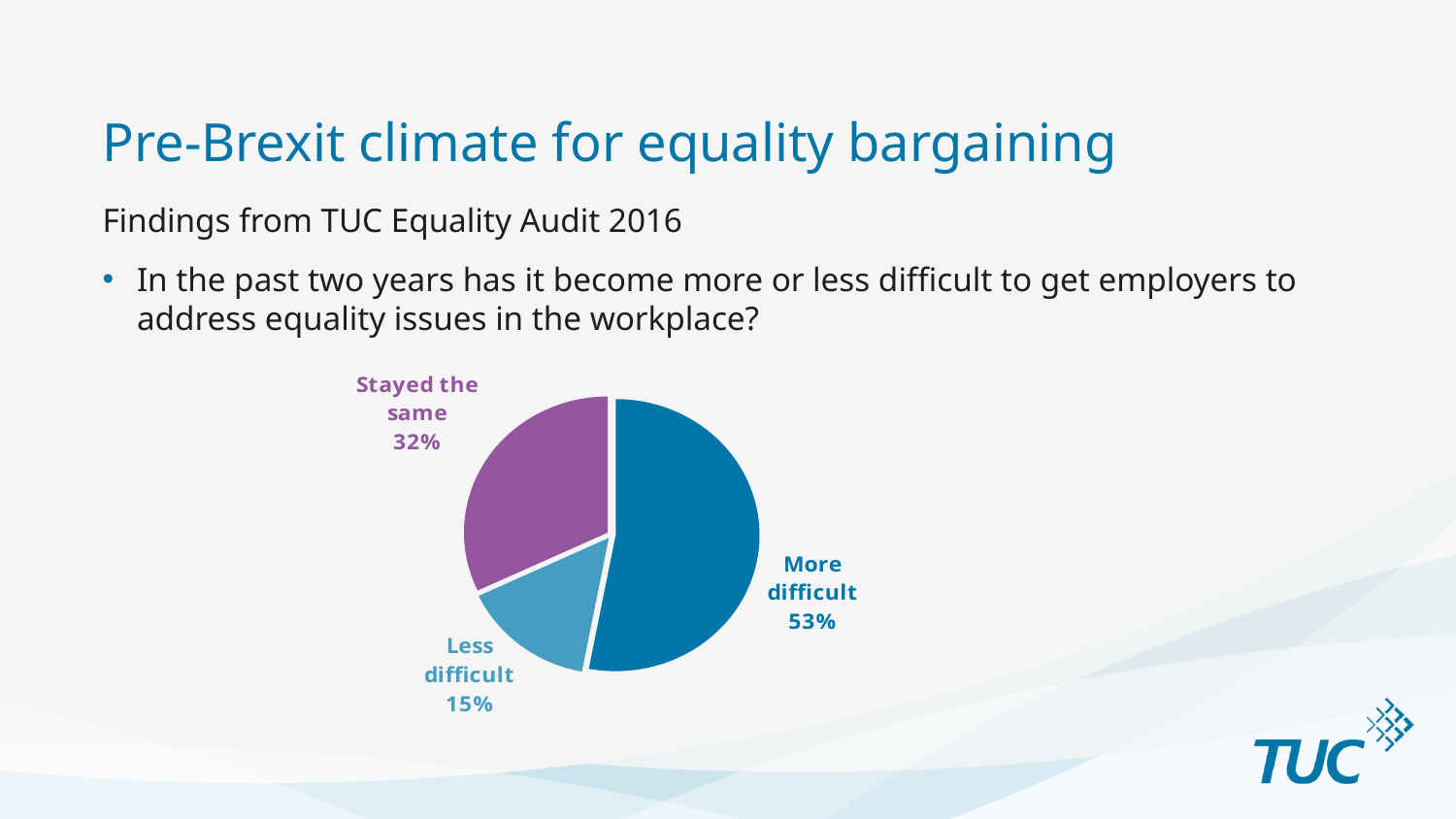
What colour is the 'Stayed the same' slice? Purple What is the difference in percentage points between 'Stayed the same' and 'Less difficult'? 17 What kind of chart is shown on the slide? Pie chart What share of the pie does the 'More difficult' slice represent? 53% What percentage of respondents said it has become more difficult? 53% What is the difference in percentage points between 'More difficult' and 'Less difficult'? 38 Which response has the largest share of the pie? More difficult How many slices does the pie chart have? 3 Which response has the smallest share of the pie? Less difficult Which is larger, the share for 'Stayed the same' or the share for 'Less difficult'? Stayed the same What percentage of respondents said it stayed the same? 32% What percentage of respondents said it has become less difficult? 15%